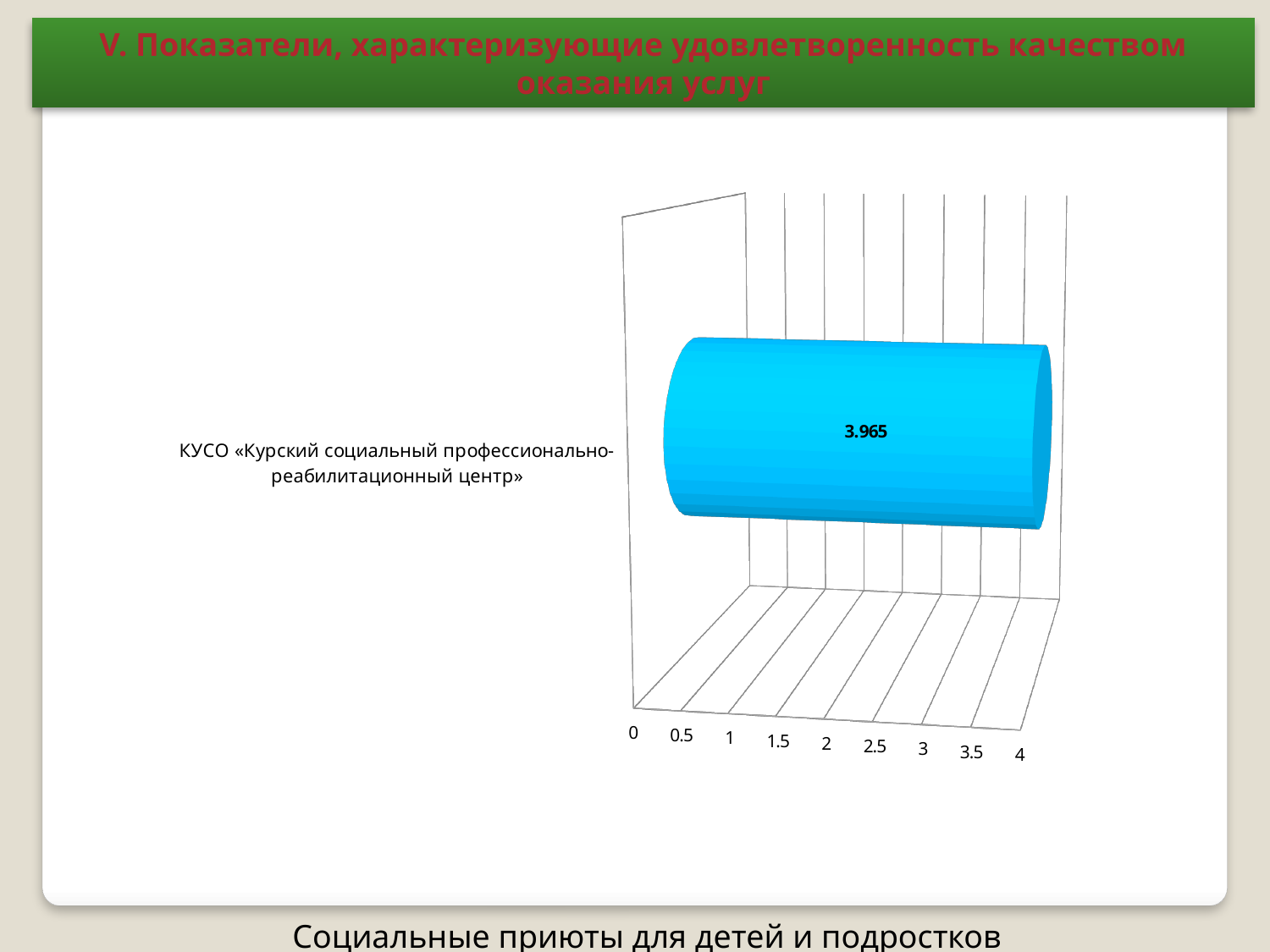
Is the value for КУСО «Курский социальный профессионально-реабилитационный центр» greater or less than 4? less What is the maximum value shown on the chart's value axis? 4 How many categories are plotted in the chart? 1 Is the value for КУСО «Курский социальный профессионально-реабилитационный центр» greater or less than 3.5? greater What kind of chart is shown on the slide? bar chart Which category is plotted in the chart? КУСО «Курский социальный профессионально-реабилитационный центр» What colour is the bar in the chart? blue What is the value shown for КУСО «Курский социальный профессионально-реабилитационный центр»? 3.965